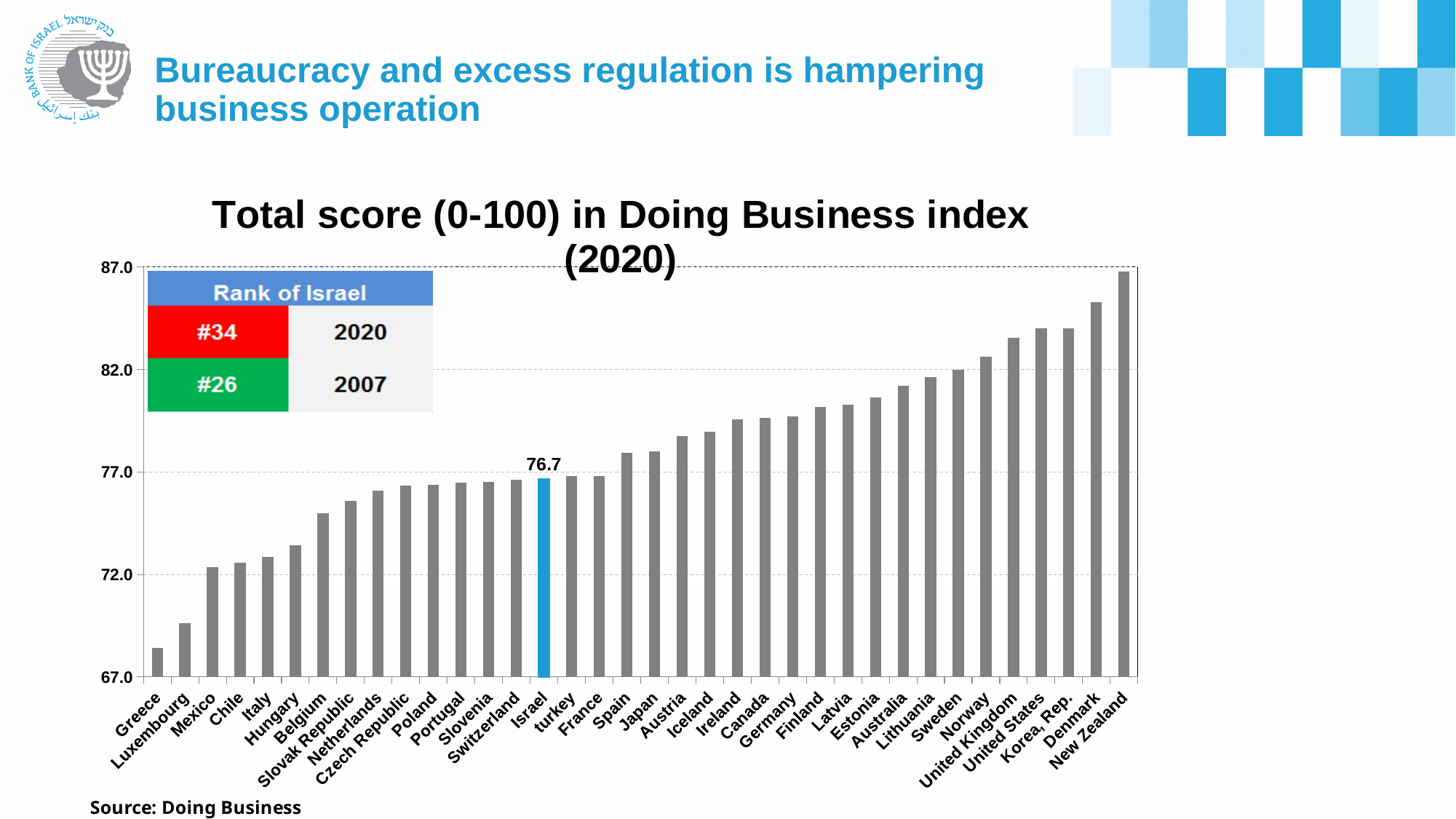
Is the value for Belgium greater or less than 77.0? less Is the value for Denmark greater or less than 82.0? greater Which country has the highest total score in the chart? New Zealand Which country has the lowest total score in the chart? Greece Which has a higher total score, Greece or Luxembourg? Luxembourg How many countries are shown in the chart? 36 What type of chart is shown on the slide? bar chart Do the bar values rise or fall moving from left to right along the x axis? rise What is the Doing Business total score shown for Israel? 76.7 Is the value for Greece greater or less than 72.0? less Which has a higher total score, Denmark or Norway? Denmark Which country's bar is highlighted in blue in the chart? Israel